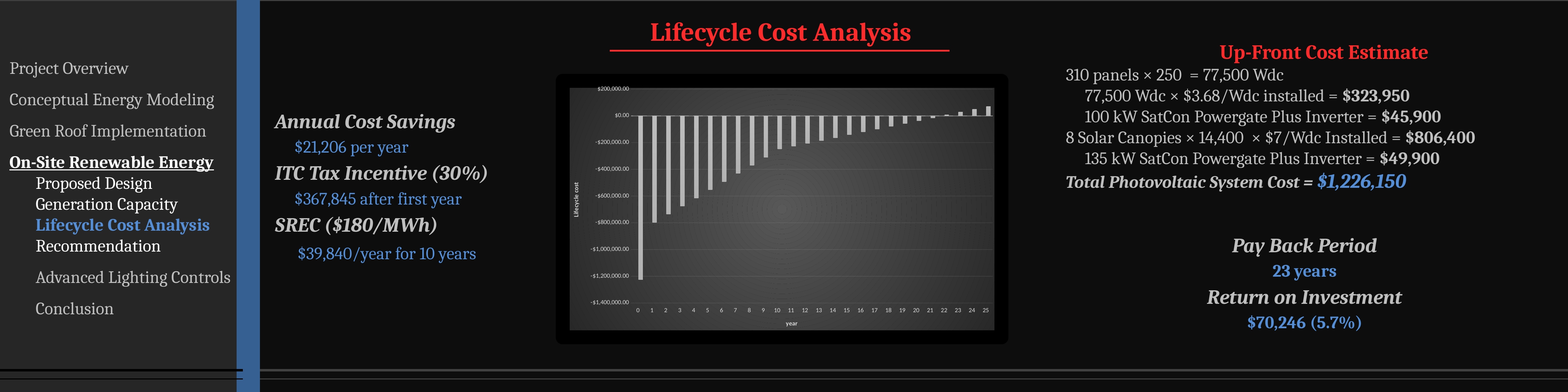
Is the lifecycle cost value for year 25 greater or less than $0.00? greater What is the label on the y axis of the chart? Lifecycle cost Is the lifecycle cost value for year 1 greater or less than -$600,000.00? less Do the lifecycle cost values rise or fall as the year increases along the x axis? rise Is the lifecycle cost value for year 0 greater or less than -$1,000,000.00? less How many years (bars) are plotted on the x axis of the chart? 26 What kind of chart is shown on the slide? bar chart Which year has the highest lifecycle cost value in the chart? 25 Which year has the lowest lifecycle cost value in the chart? 0 Which year has the larger lifecycle cost value, year 5 or year 15? 15 What is the label on the x axis of the chart? year